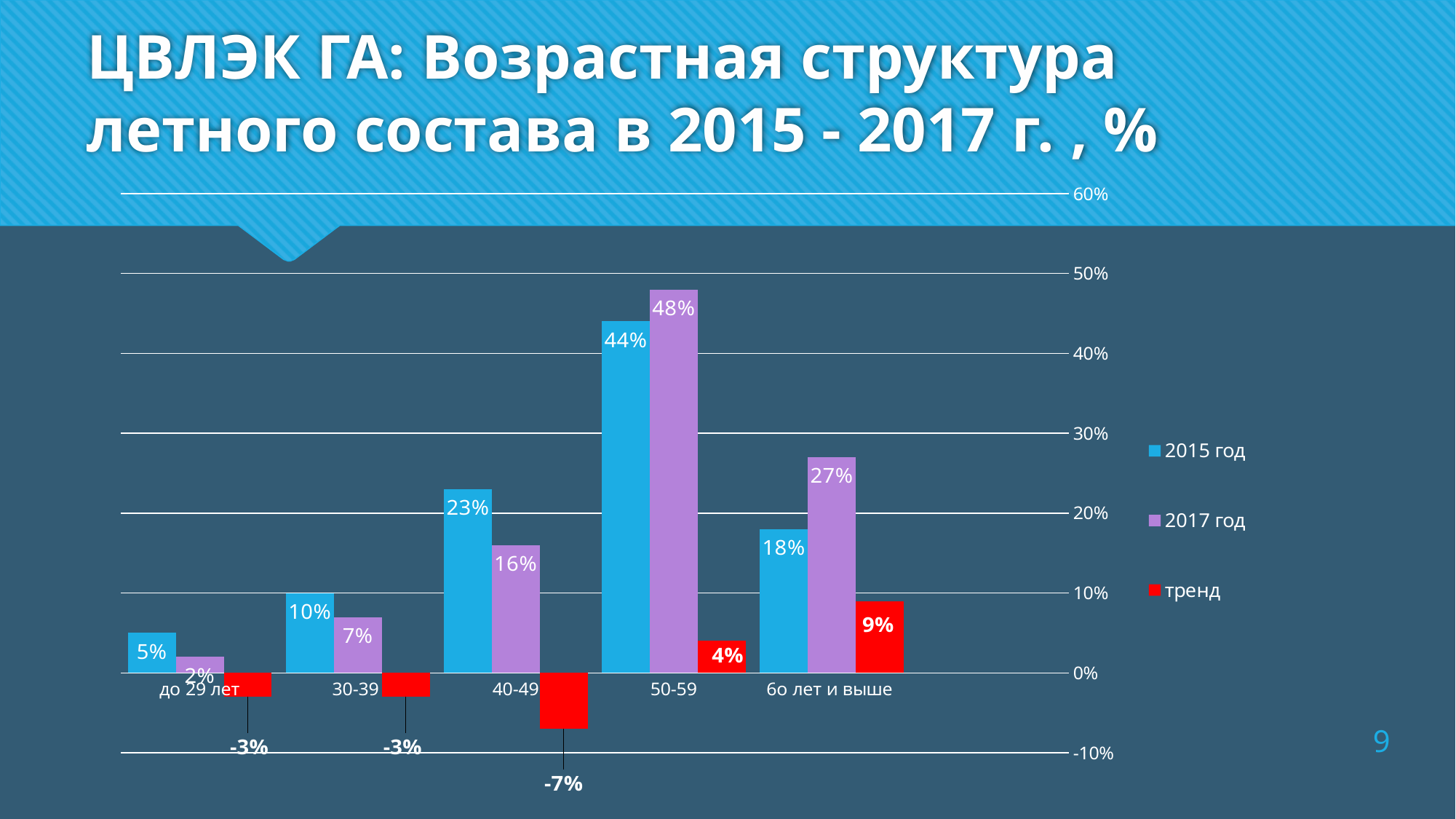
What is the тренд value for the 60 лет и выше age group? 9% Which age group has the lowest value in the 2017 год series? до 29 лет What is the value for the 50-59 age group in the 2017 год series? 48% What is the тренд value for the 40-49 age group? -7% Which age group has the highest value in the 2015 год series? 50-59 How many series does the legend list? 3 What kind of chart is shown on the slide? bar chart What is the difference between the 2017 год and 2015 год values for the 60 лет и выше age group? 9% What is the value for the 40-49 age group in the 2015 год series? 23% Which is larger for the 30-39 age group: the 2015 год value or the 2017 год value? 2015 год How many age groups are shown on the x axis? 5 What colour are the bars for the тренд series? red